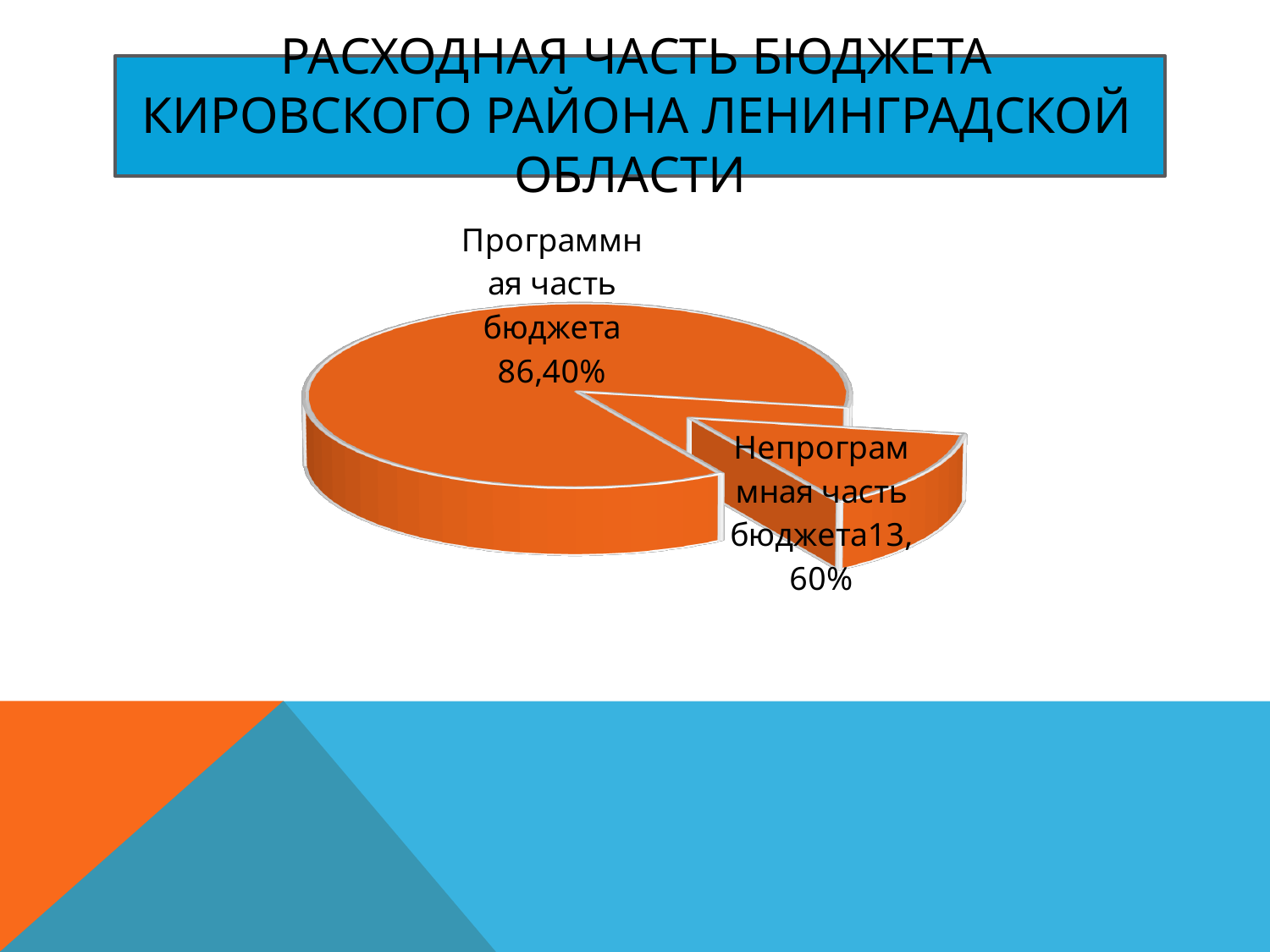
What share of the budget is the non-programme part (Непрограммная часть бюджета)? 13,60% What share of the budget is the programme part (Программная часть бюджета)? 86,40% What kind of chart is shown on the slide? Pie chart Which slice of the pie is the smallest? Непрограммная часть бюджета Which is larger: the programme part or the non-programme part of the budget? Программная часть бюджета What is the difference in percentage points between the programme part and the non-programme part of the budget? 72,80 What is the title of the slide containing the chart? Расходная часть бюджета Кировского района Ленинградской области How many slices does the pie chart have? 2 Which slice of the pie is the largest? Программная часть бюджета What colour are the slices of the pie chart? Orange